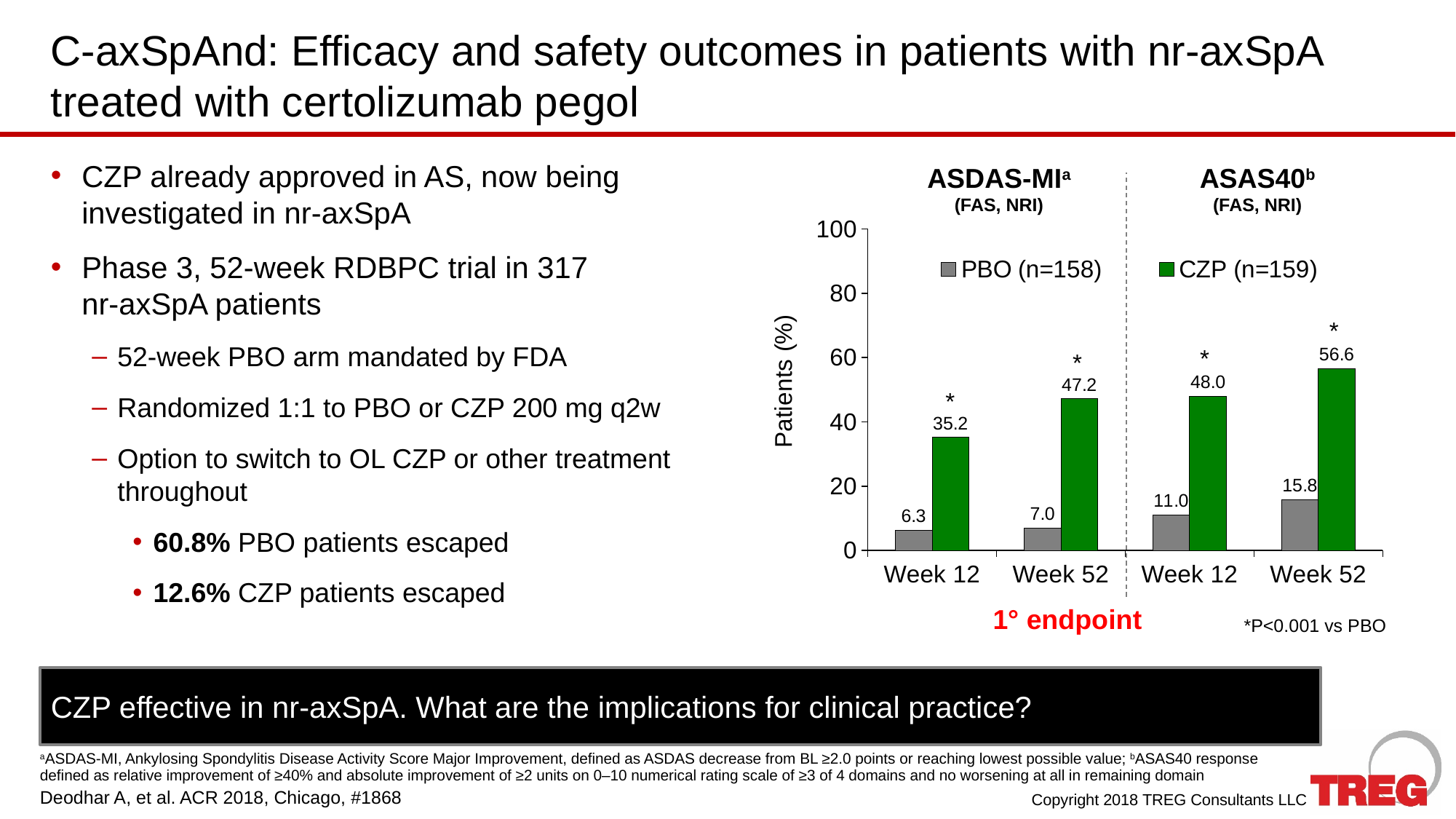
What is the CZP value for ASAS40 at Week 52? 56.6 What is the difference between the CZP and PBO values for ASDAS-MI at Week 52? 40.2 Which is larger for ASAS40 at Week 12: the PBO value or the CZP value? CZP Which bar has the highest value on the chart? CZP, ASAS40 Week 52 What kind of chart is shown on the slide? Bar chart What is the difference between the CZP and PBO values for ASAS40 at Week 12? 37.0 What is the PBO value for ASAS40 at Week 52? 15.8 Is the CZP value for ASDAS-MI at Week 52 greater or less than 40? greater How many series does the legend list? 2 Which bar has the lowest value on the chart? PBO, ASDAS-MI Week 12 What is the CZP value for ASDAS-MI at Week 12? 35.2 What is the PBO value for ASDAS-MI at Week 52? 7.0